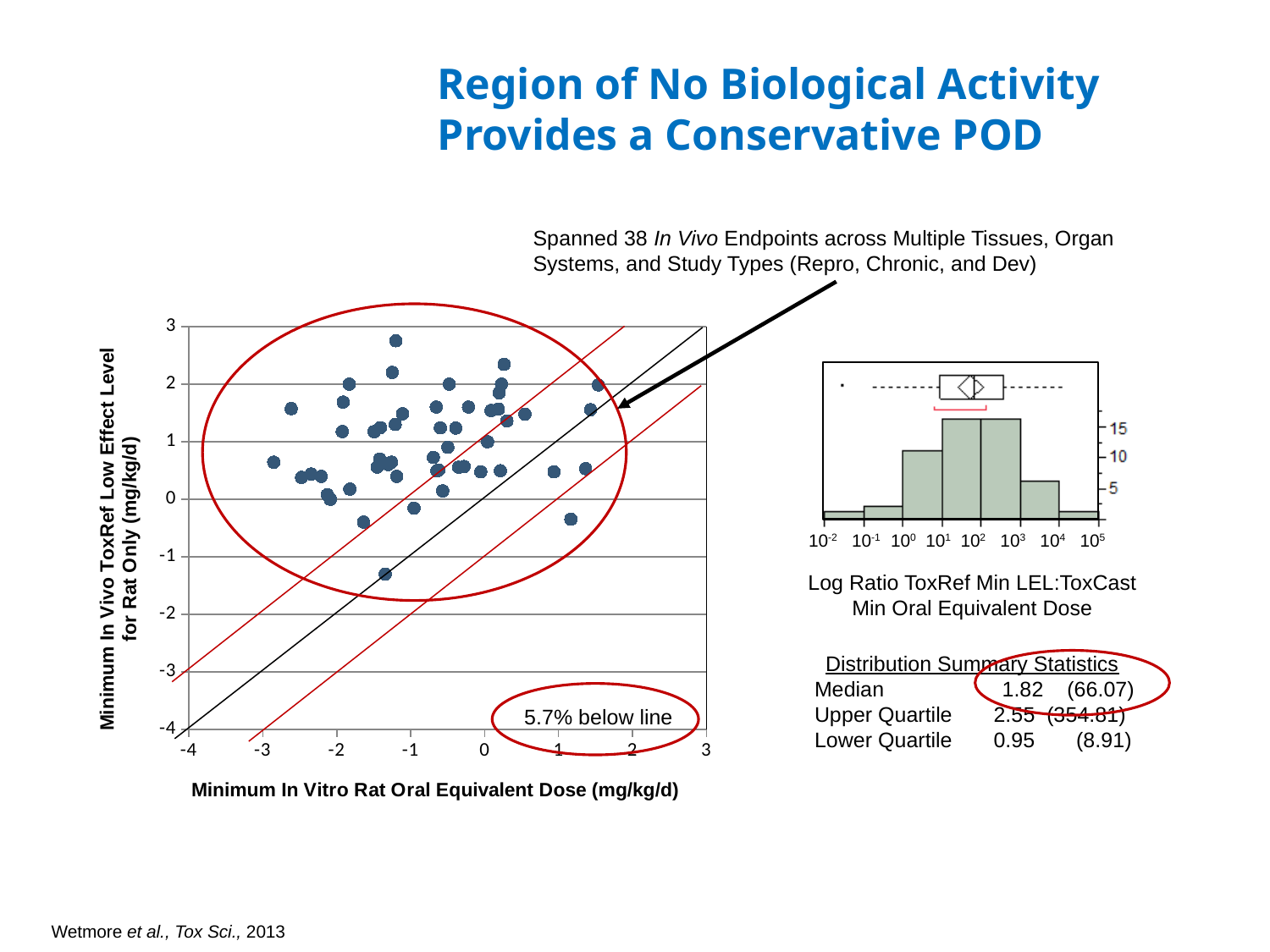
In the histogram on the right, is the bar for the 10^0 to 10^1 bin greater or less than 5? greater In the scatter plot on the left, what is the highest value shown on the y axis? 3 What kind of chart is shown on the right of the slide, below the box plot? histogram (bar chart) In the Distribution Summary Statistics for the histogram on the right, what is the upper quartile value? 2.55 In the scatter plot on the left, what percentage of points is annotated as being below the line? 5.7% In the Distribution Summary Statistics for the histogram on the right, what is the lower quartile value? 0.95 What kind of chart is the chart on the left of the slide? scatter plot In the histogram on the right, is the bar for the 10^-1 to 10^0 bin greater or less than 5? less In the histogram on the right, is the bar for the 10^4 to 10^5 bin greater or less than 5? less In the Distribution Summary Statistics for the histogram on the right, what is the median log ratio? 1.82 In the scatter plot on the left, what is the label of the x axis? Minimum In Vitro Rat Oral Equivalent Dose (mg/kg/d)